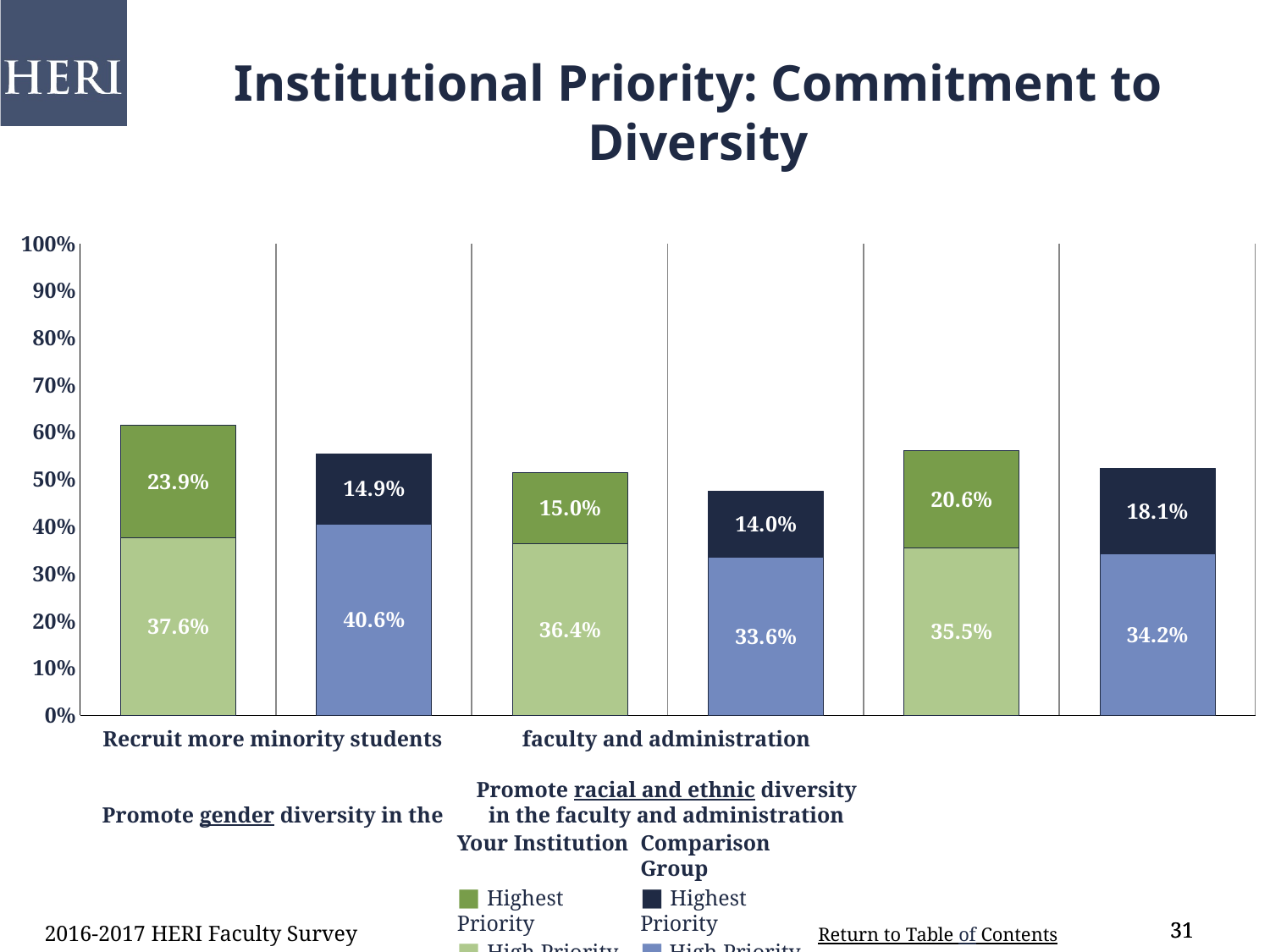
How much higher is Your Institution's Highest Priority value than the Comparison Group's for 'Recruit more minority students'? 9.0% What type of chart is shown on the slide? Stacked bar chart What is the combined High Priority and Highest Priority total for the Comparison Group on 'Promote gender diversity in the faculty and administration'? 47.6% What is the combined High Priority and Highest Priority total for Your Institution on 'Recruit more minority students'? 61.5% Which category has the lowest High Priority value for the Comparison Group? Promote gender diversity in the faculty and administration What is the High Priority value for the Comparison Group on 'Recruit more minority students'? 40.6% What is the High Priority value for Your Institution on 'Promote racial and ethnic diversity in the faculty and administration'? 35.5% How many categories are shown on the x axis of the chart? 3 Which has the larger Highest Priority value for 'Promote racial and ethnic diversity in the faculty and administration': Your Institution or the Comparison Group? Your Institution What is the Highest Priority value for the Comparison Group on 'Promote gender diversity in the faculty and administration'? 14.0% What percentage of Your Institution rated 'Recruit more minority students' as Highest Priority? 23.9% Which category has the highest Highest Priority value for Your Institution? Recruit more minority students